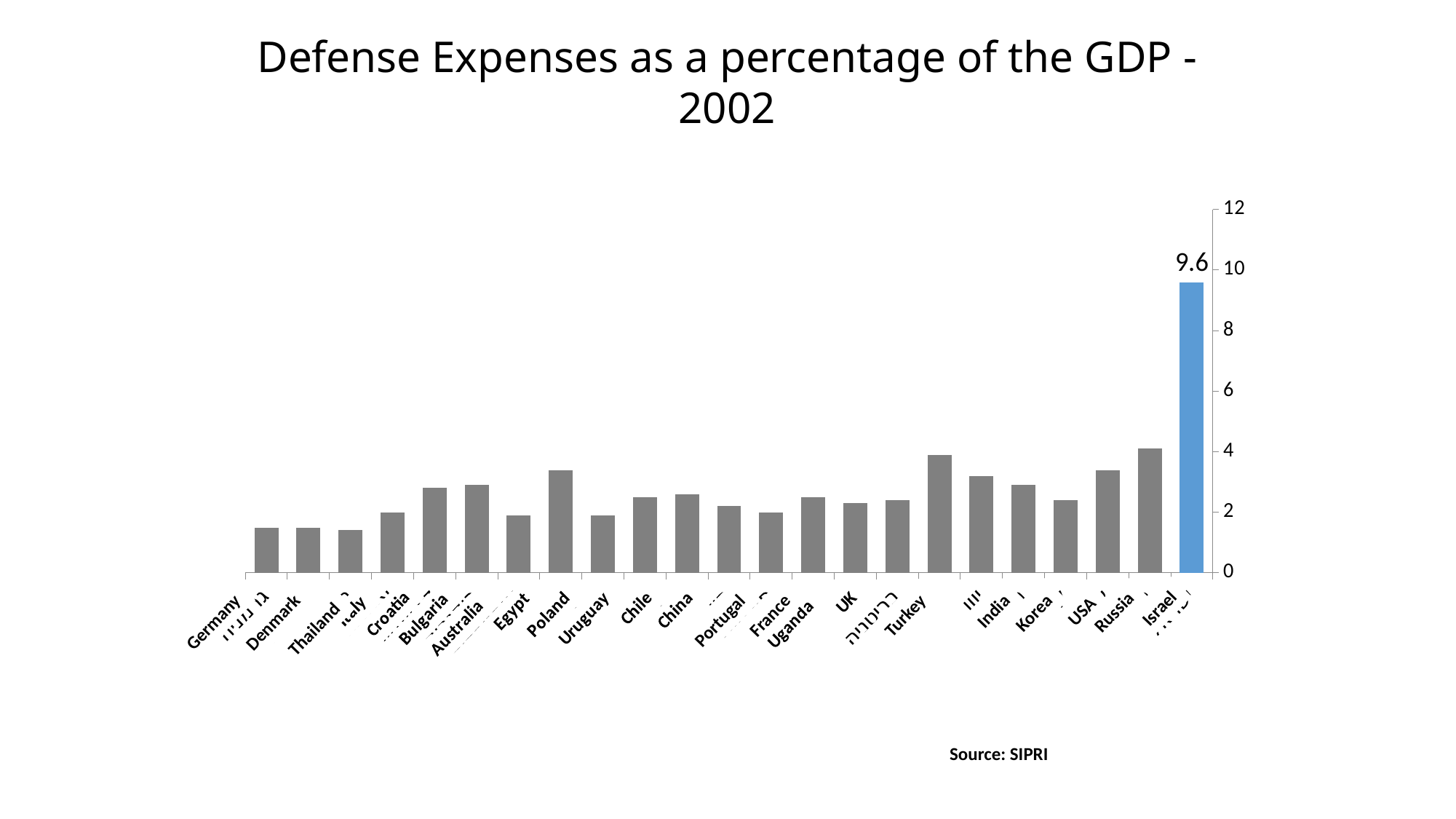
What type of chart is shown on the slide? bar chart Which has a larger value, Turkey or Germany? Turkey What is the value shown for Israel? 9.6 Which country has the highest defense expenses as a percentage of GDP? Israel What is the title of the chart? Defense Expenses as a percentage of the GDP - 2002 Which has a larger value, Israel or USA? Israel Is the value for Bulgaria greater or less than 2? greater Is the value for Turkey greater or less than 3? greater Is the value for Israel greater or less than 8? greater Which has a larger value, Poland or Uruguay? Uruguay Which bar is highlighted in a different colour (blue) from the others? Israel